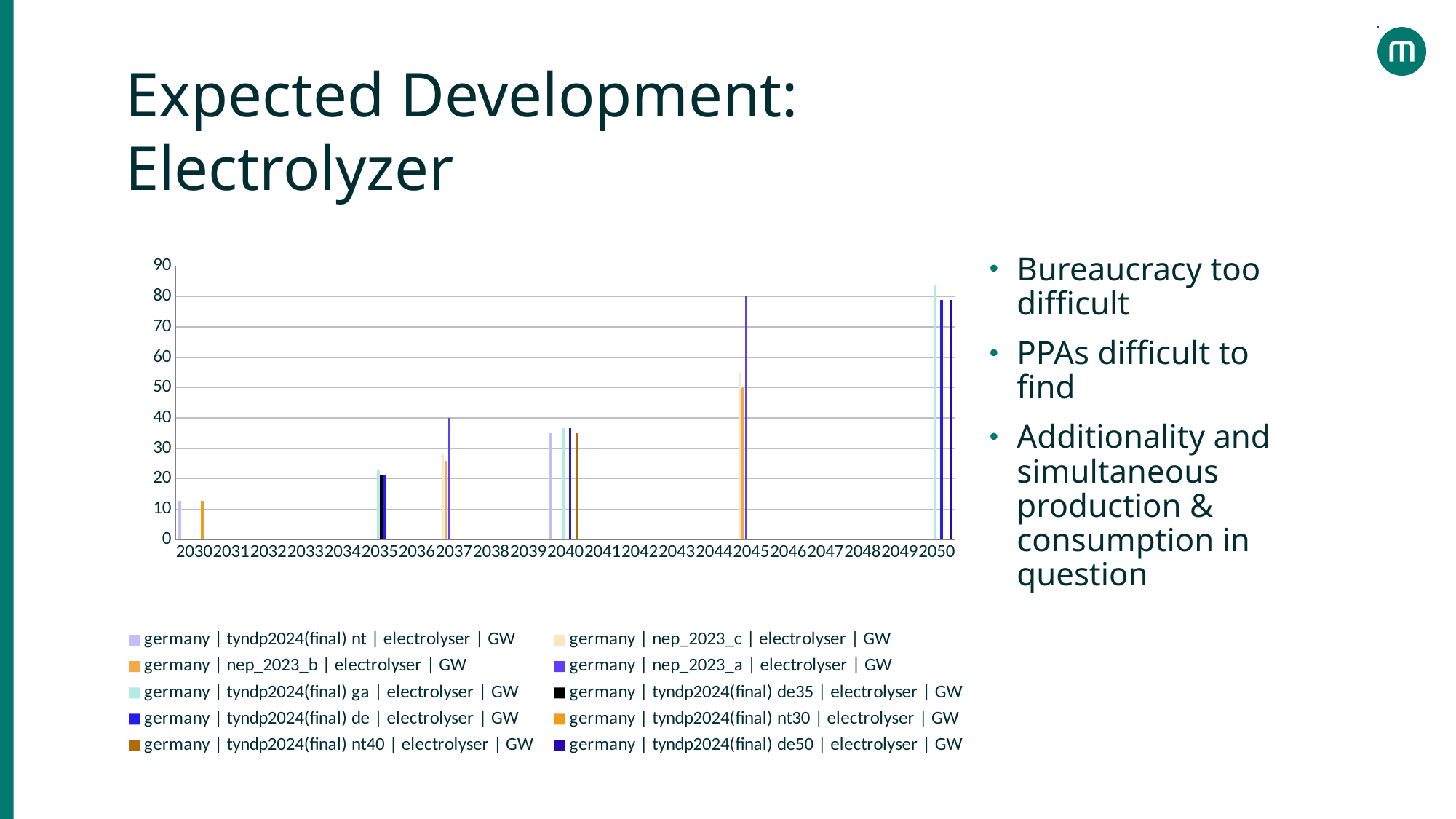
Is the value for germany | tyndp2024(final) nt | electrolyser | GW in 2040 greater or less than 40? less Which series in the legend is shown in black? germany | tyndp2024(final) de35 | electrolyser | GW What kind of chart is shown on the slide? bar chart Is the value for germany | nep_2023_a | electrolyser | GW in 2045 greater or less than 70? greater Is the value for germany | nep_2023_c | electrolyser | GW in 2045 greater or less than 50? greater How many series does the chart legend list? 10 How many year categories are shown on the x axis of the chart? 21 In 2045, which is larger: the value for germany | nep_2023_a | electrolyser | GW or the value for germany | nep_2023_c | electrolyser | GW? germany | nep_2023_a | electrolyser | GW